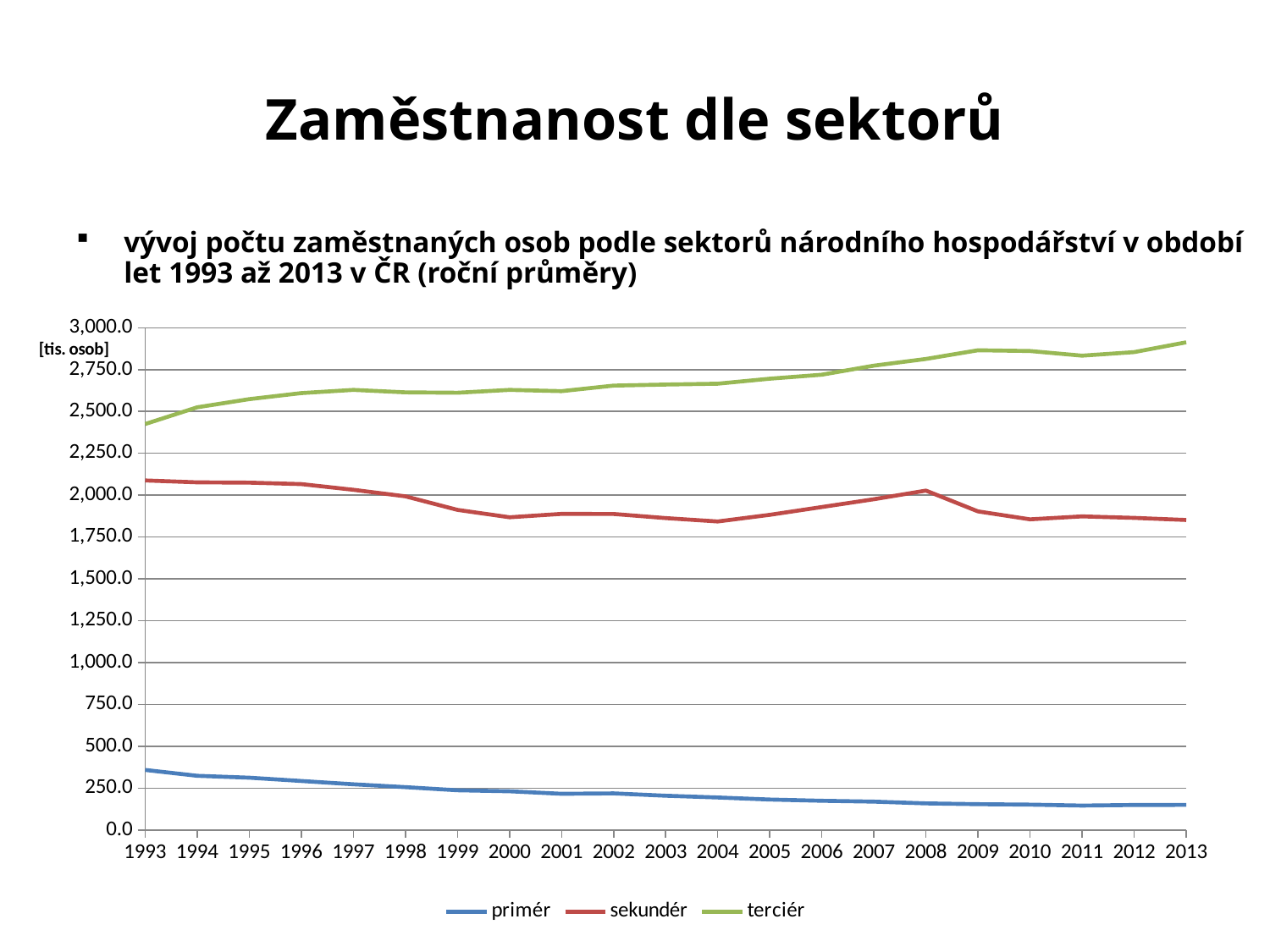
Is the value for sekundér in 2013 greater or less than 2,000.0? less Is the value for primér in 1993 greater or less than 250.0? greater Is the value for terciér in 2013 greater or less than 2,750.0? greater What kind of chart is shown on the slide? line chart How many series does the legend list? 3 Does the primér series rise or fall from 1993 to 2013? fall Which series has the lowest values across the whole period? primér Does the terciér series rise or fall overall from 1993 to 2013? rise Which series has the highest values across the whole period? terciér How many years are plotted along the x axis? 21 What unit label is shown at the top of the vertical axis? [tis. osob]